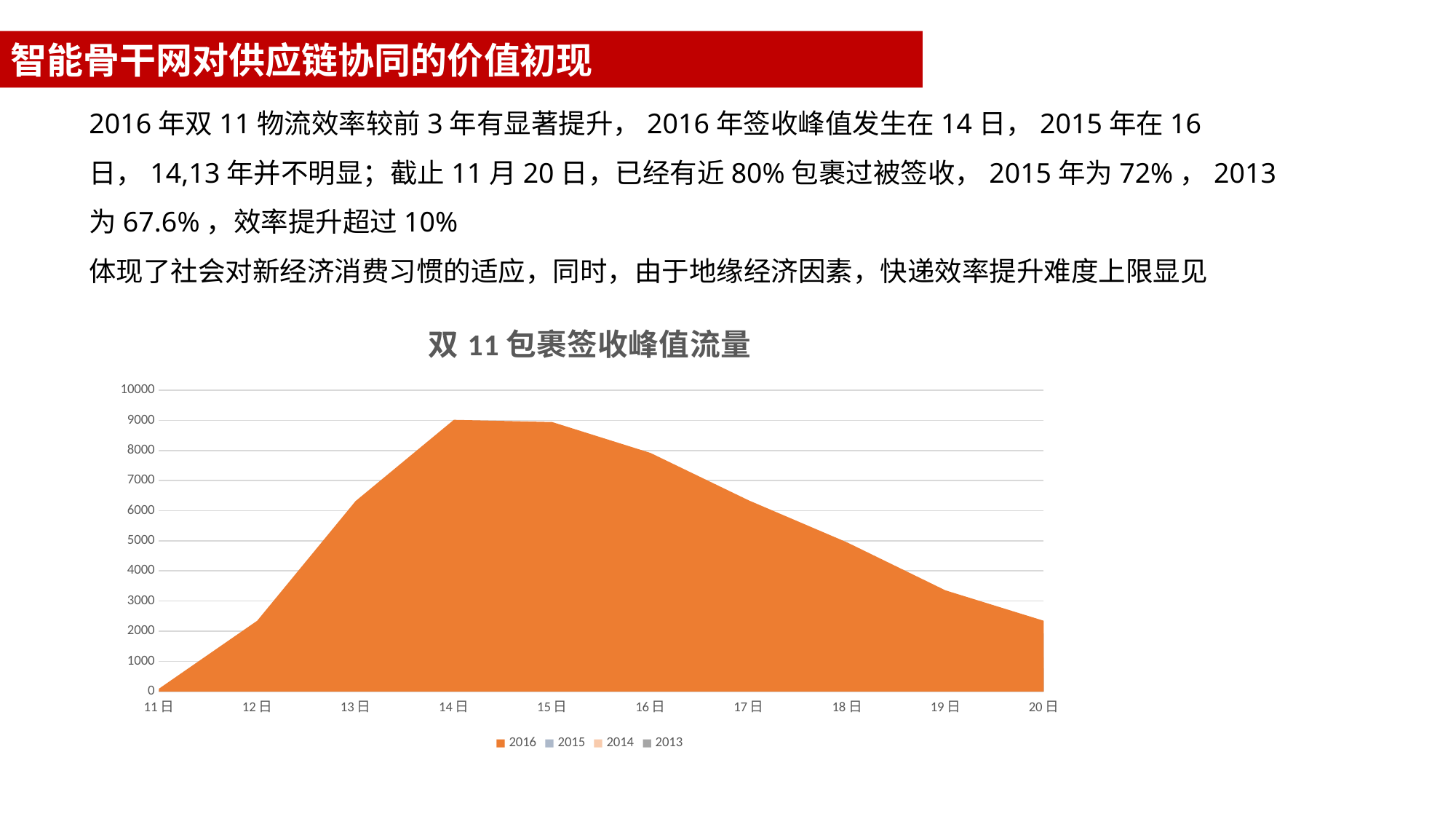
How many dates are shown along the x axis of the chart? 10 How many series does the chart legend list? 4 Is the value for 12 日 greater or less than 3000? less What is the title of the chart? 双 11 包裹签收峰值流量 Is the value for 13 日 greater or less than 6000? greater What kind of chart is shown on the slide? area chart On which date is the 2016 series at its lowest value? 11 日 Do the values rise or fall from 14 日 to 20 日? fall Which date has the larger value, 13 日 or 19 日? 13 日 On which date does the 2016 series reach its highest value? 14 日